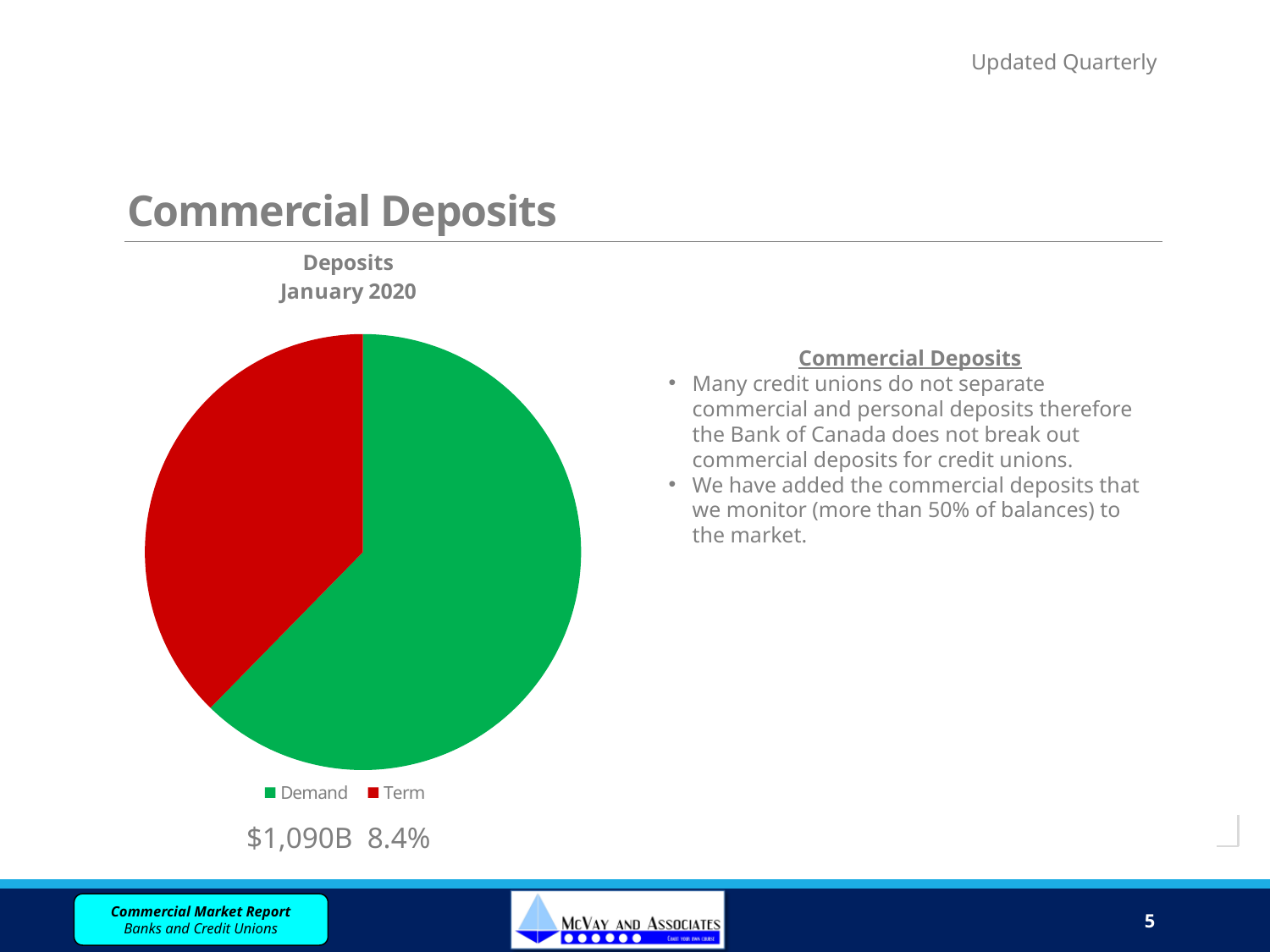
Which colour represents Demand in the pie chart? green Does the Demand slice take up more or less than half of the pie chart? more How many slices does the pie chart have? 2 Which category has the smallest slice of the pie chart? Term Which category has the largest slice of the pie chart? Demand Which slice is larger in the pie chart, Demand or Term? Demand What is the title of the pie chart? Deposits January 2020 How many entries does the legend of the pie chart list? 2 What kind of chart is shown on the slide? pie chart